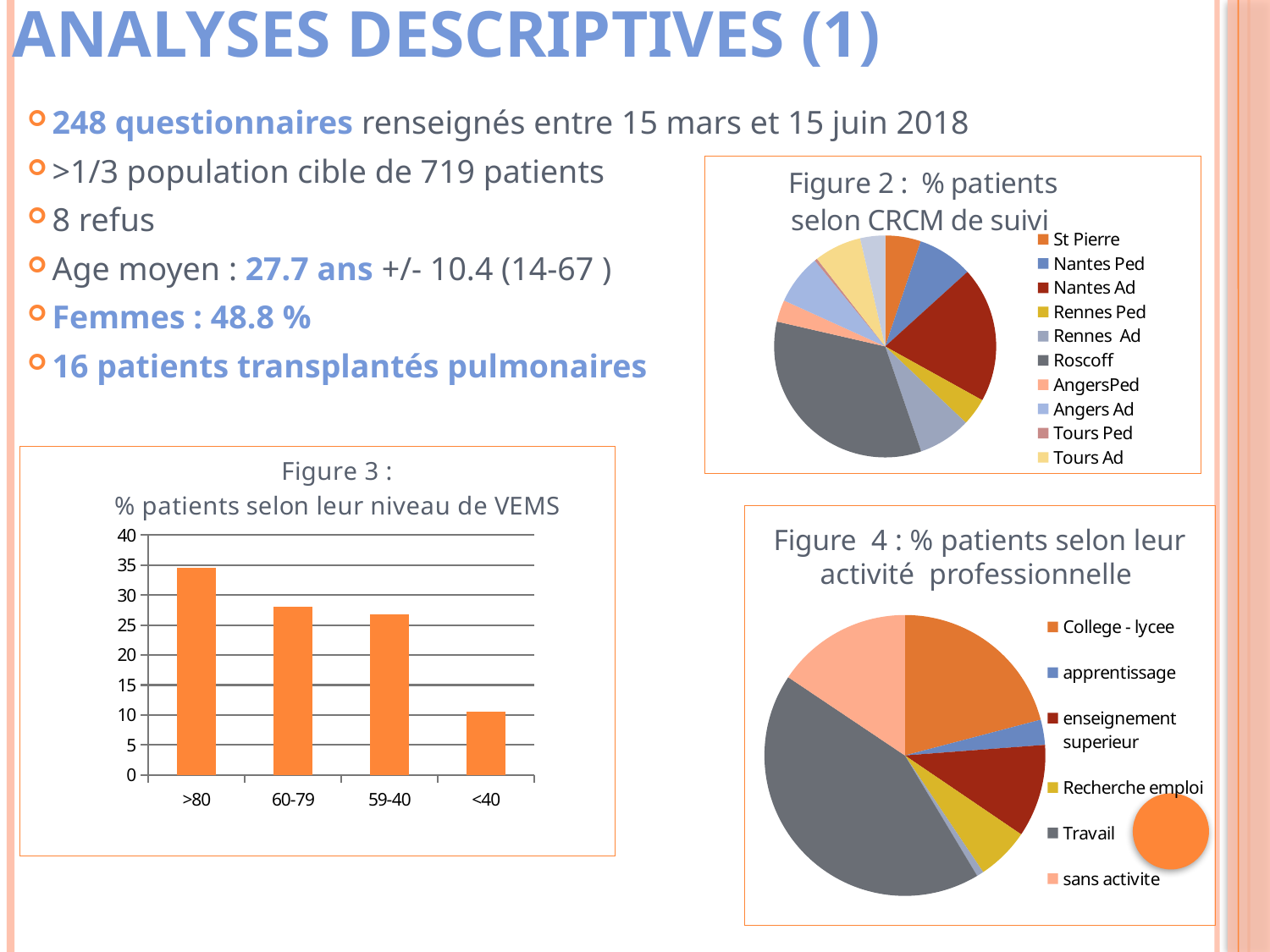
What kind of chart is Figure 3 (% patients selon leur niveau de VEMS)? bar chart In Figure 3, is the value for 60-79 greater or less than 25? greater In Figure 3, which is larger, the value for >80 or the value for <40? >80 In Figure 3, how many VEMS categories are shown on the x axis? 4 What kind of chart is Figure 2 (% patients selon CRCM de suivi)? pie chart In Figure 3, which VEMS category has the lowest percentage of patients? <40 In Figure 3, is the value for >80 greater or less than 30? greater In Figure 4 (% patients selon leur activité professionnelle), which category has the largest slice? Travail In Figure 3, do the values rise or fall from >80 to <40 along the x axis? fall In Figure 3, is the value for <40 greater or less than 15? less In Figure 3, which VEMS category has the highest percentage of patients? >80 In Figure 2, how many CRCM entries does the legend list? 10